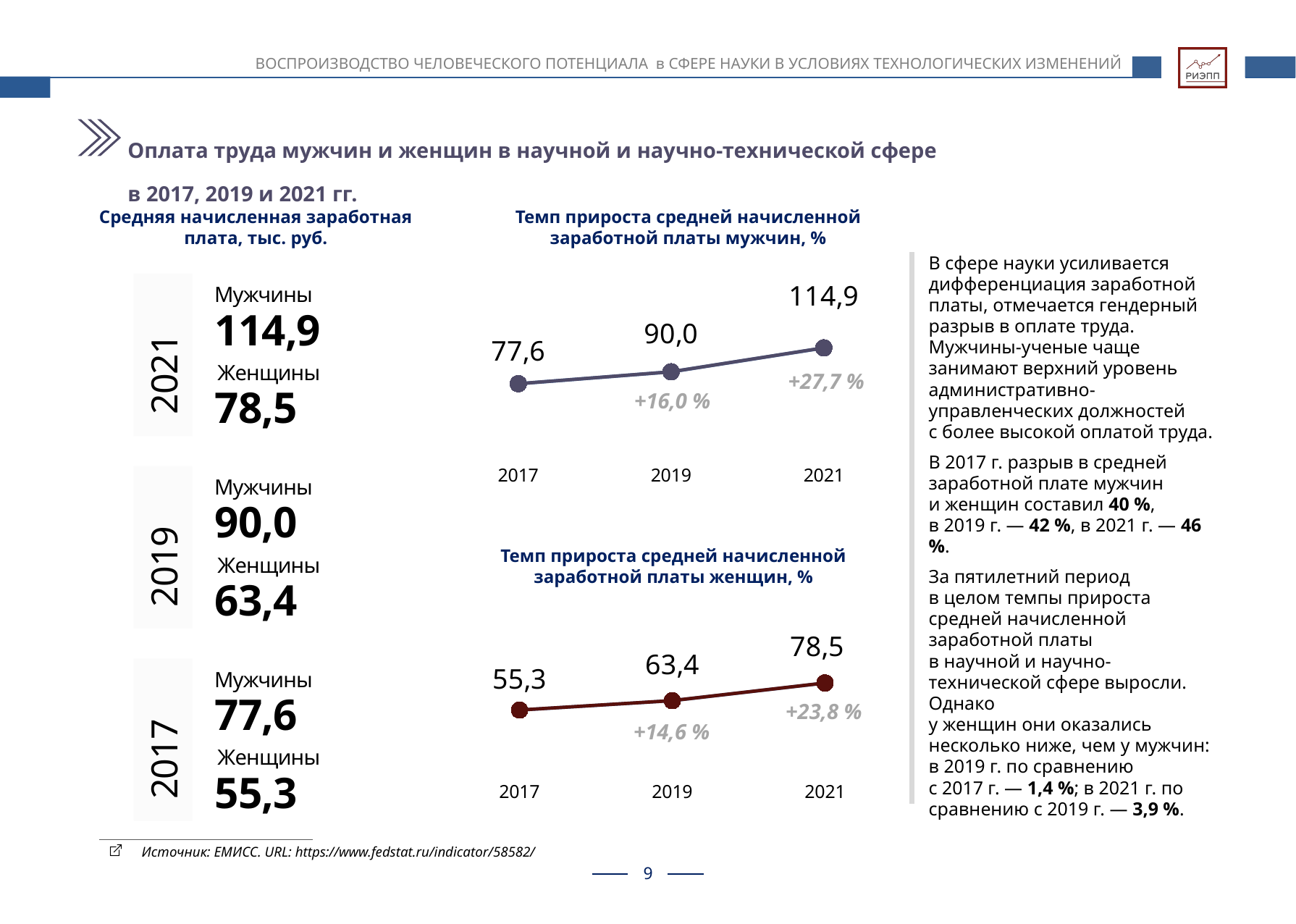
In the chart 'Темп прироста средней начисленной заработной платы женщин, %', what growth rate is shown between 2017 and 2019? +14,6 % In the chart 'Темп прироста средней начисленной заработной платы женщин, %', what is the value for 2017? 55,3 How many data points are plotted in the chart 'Темп прироста средней начисленной заработной платы мужчин, %'? 3 In the chart 'Темп прироста средней начисленной заработной платы мужчин, %', what is the value for 2021? 114,9 What type of chart is 'Темп прироста средней начисленной заработной платы женщин, %'? line chart In the chart 'Темп прироста средней начисленной заработной платы женщин, %', do the values rise or fall from 2017 to 2021? rise In the chart 'Темп прироста средней начисленной заработной платы мужчин, %', what growth rate is shown between 2019 and 2021? +27,7 % In the chart 'Темп прироста средней начисленной заработной платы женщин, %', what is the value for 2021? 78,5 In the chart 'Темп прироста средней начисленной заработной платы женщин, %', which year has the lowest value? 2017 In the chart 'Темп прироста средней начисленной заработной платы мужчин, %', which year has the highest value? 2021 In the chart 'Темп прироста средней начисленной заработной платы мужчин, %', what is the value for 2019? 90,0 In the chart 'Темп прироста средней начисленной заработной платы мужчин, %', what is the difference between the 2021 and 2017 values? 37,3